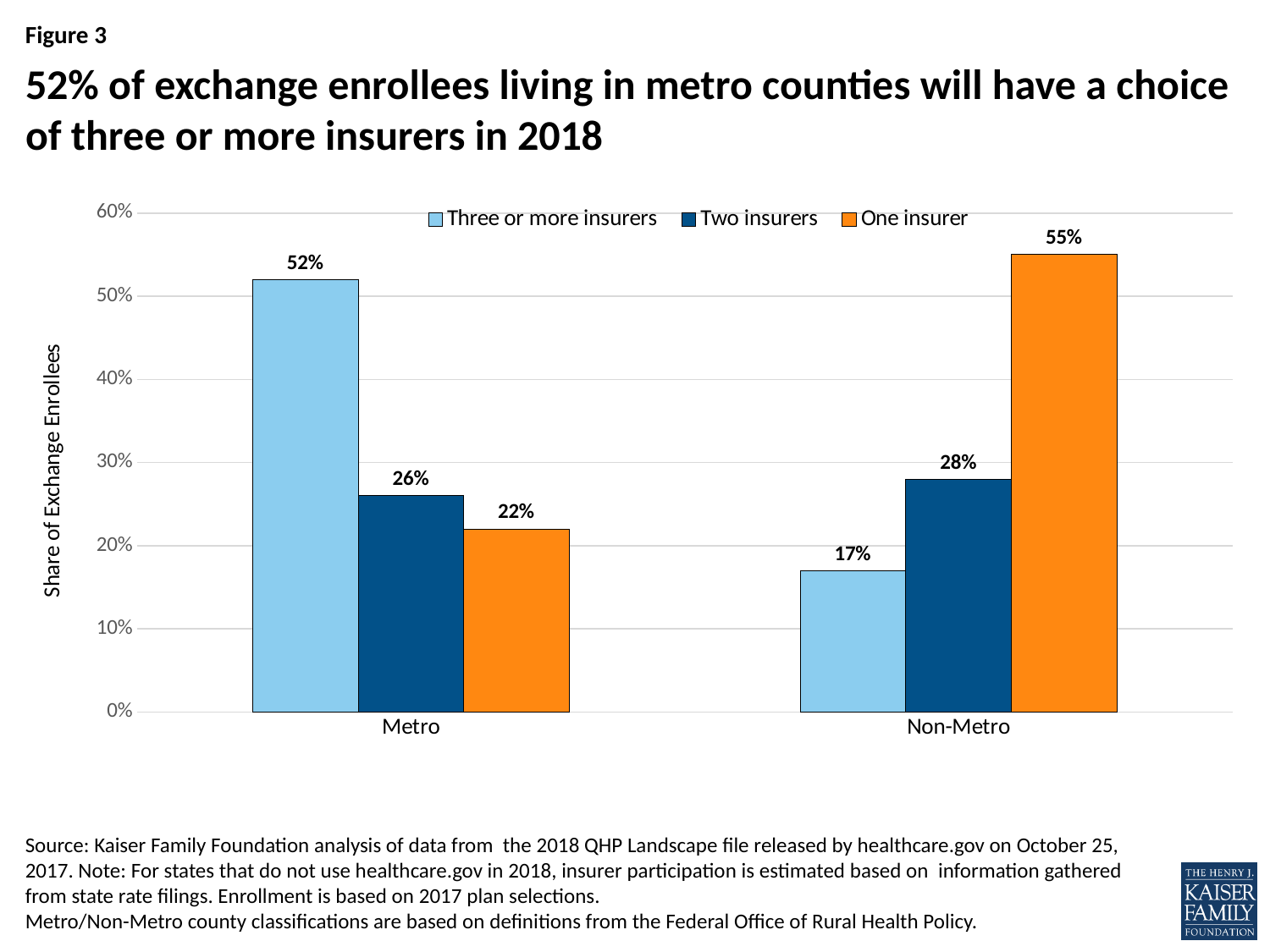
Which series has the lowest value in the Metro category? One insurer What kind of chart is shown on the slide? Bar chart How many categories are shown on the x axis? 2 Which series has the highest value in the Non-Metro category? One insurer Is the value for One insurer in Metro counties greater or less than 30%? less What is the value for Two insurers in the Non-Metro category? 28% What share of exchange enrollees in Metro counties will have a choice of three or more insurers? 52% How many series does the legend list? 3 What is the difference between the Metro and Non-Metro values for Three or more insurers? 35 percentage points What share of exchange enrollees in Non-Metro counties will have only one insurer? 55% Which is larger: the Two insurers value for Metro or for Non-Metro? Non-Metro What is the label of the y axis? Share of Exchange Enrollees